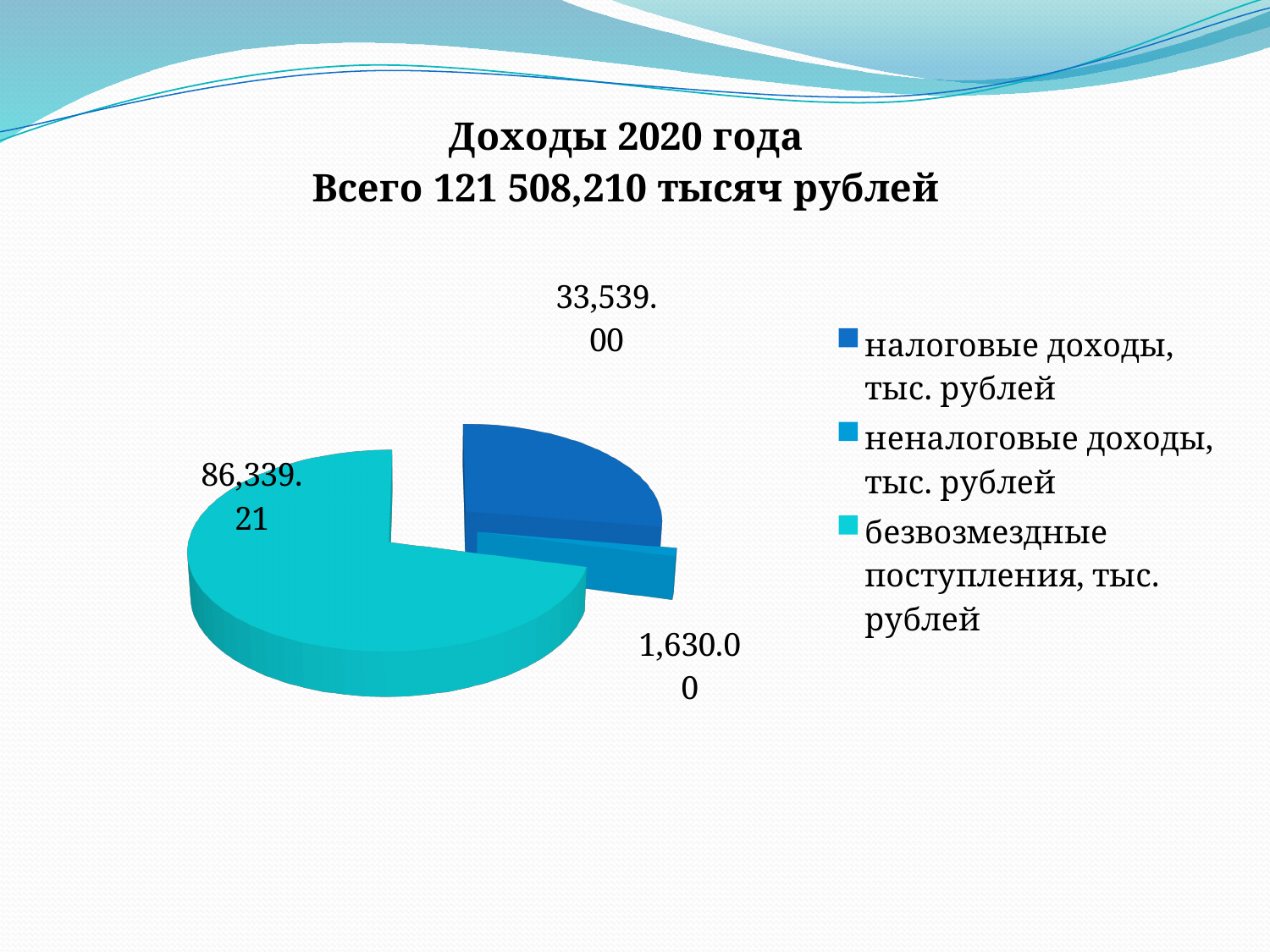
What is the difference between безвозмездные поступления and налоговые доходы? 52,800.21 What is the value for налоговые доходы, тыс. рублей? 33,539.00 What kind of chart is shown on the slide? pie chart Which category has the largest slice of the pie? безвозмездные поступления, тыс. рублей What is the value for неналоговые доходы, тыс. рублей? 1,630.00 Which is larger, налоговые доходы or неналоговые доходы? налоговые доходы Which category has the smallest slice of the pie? неналоговые доходы, тыс. рублей What is the value for безвозмездные поступления, тыс. рублей? 86,339.21 How many entries does the legend list? 3 What total amount is stated in the chart title? 121 508,210 тысяч рублей What is the difference between налоговые доходы and неналоговые доходы? 31,909.00 How many slices does the pie chart have? 3